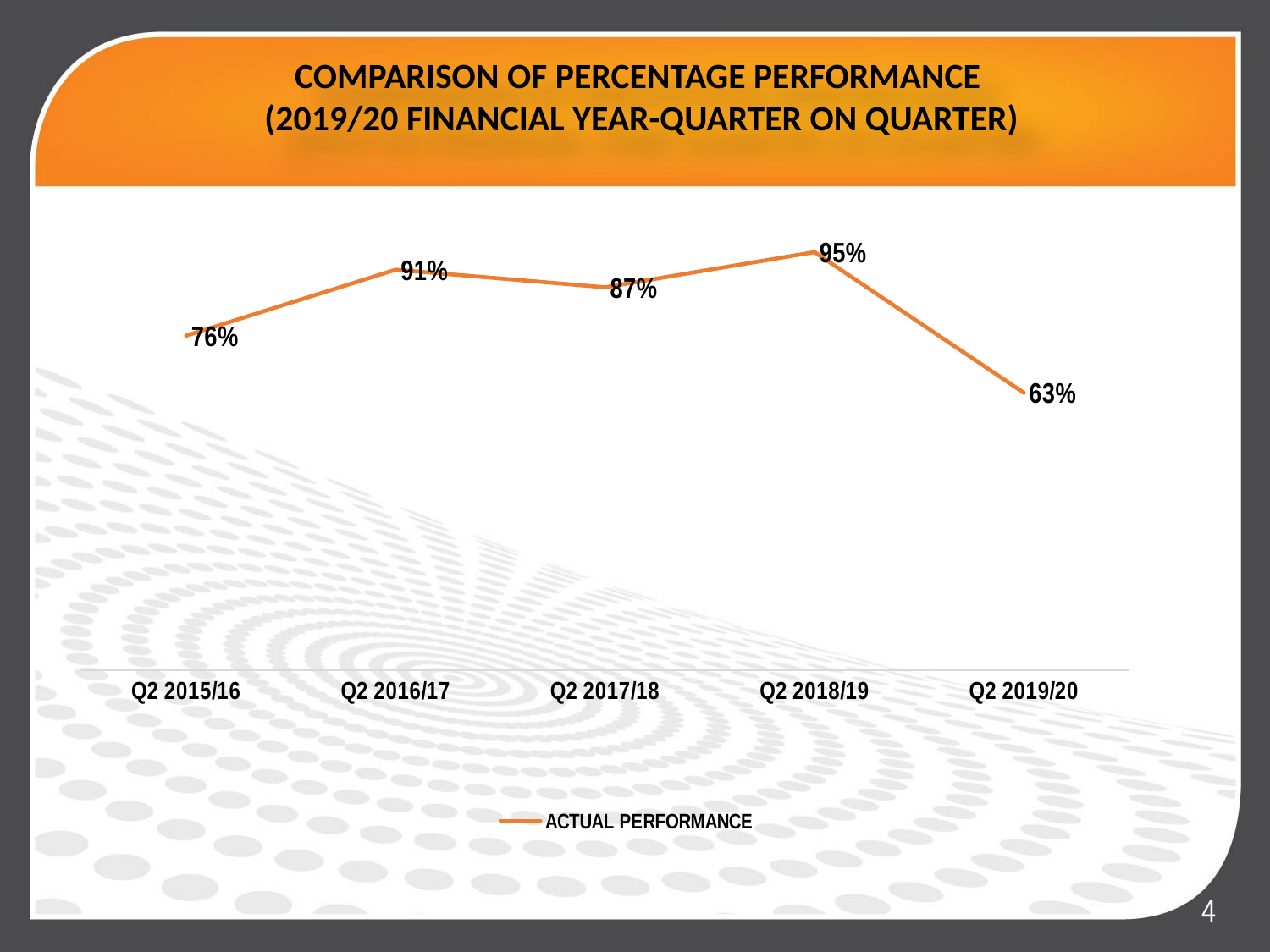
What is the actual performance for Q2 2019/20? 63% What kind of chart is shown on the slide? Line chart What is the actual performance for Q2 2017/18? 87% What is the name of the series shown in the legend? ACTUAL PERFORMANCE What is the difference between the actual performance in Q2 2018/19 and Q2 2019/20? 32% Which quarter has the highest actual performance? Q2 2018/19 What is the difference between the actual performance in Q2 2016/17 and Q2 2015/16? 15% Which quarter has the lowest actual performance? Q2 2019/20 How many quarters are plotted on the chart? 5 How many series does the legend list? 1 Which is larger, the actual performance in Q2 2016/17 or Q2 2017/18? Q2 2016/17 What is the actual performance for Q2 2015/16? 76%